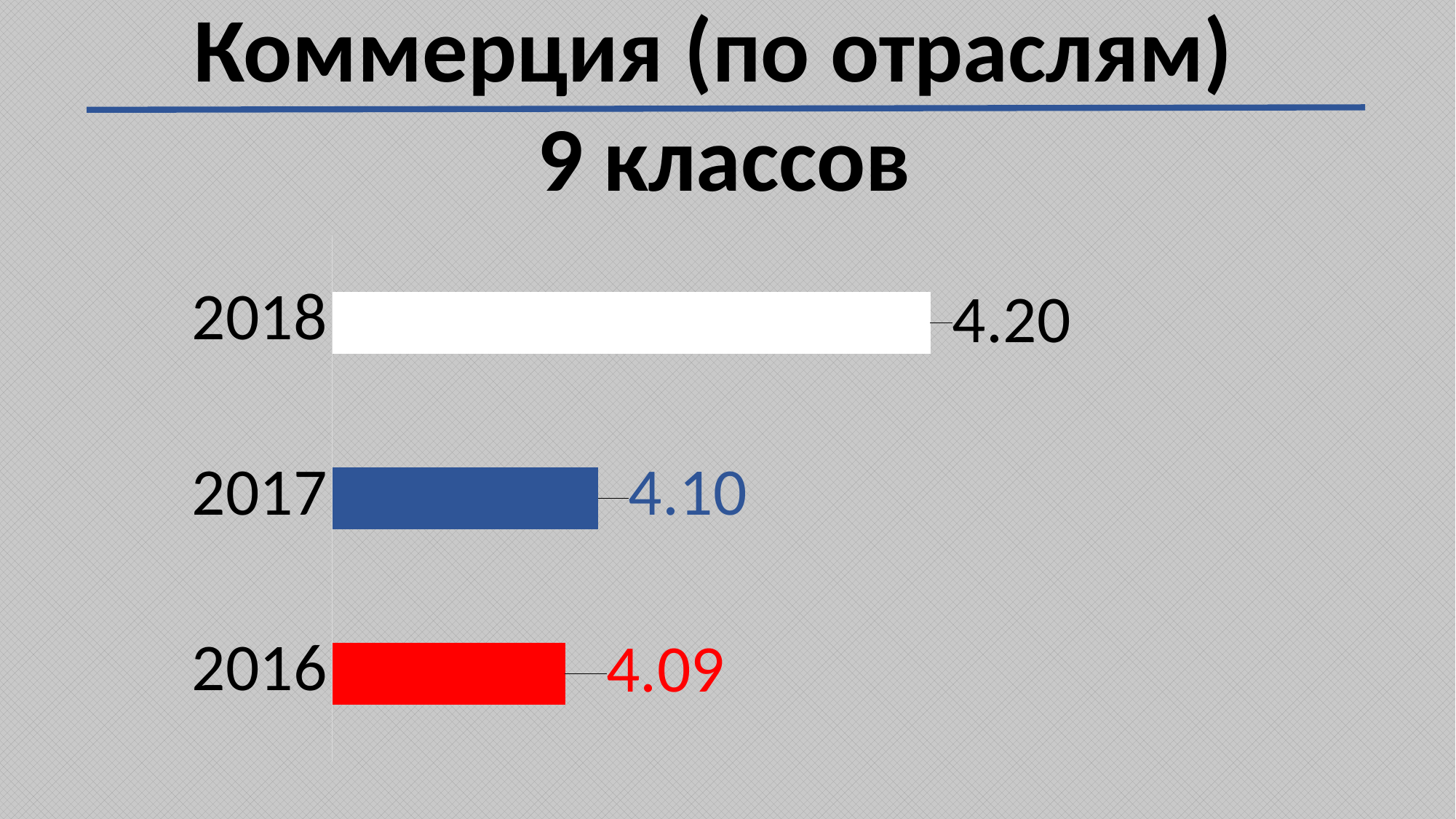
What is the value for 2016? 4.09 Which year has the lowest value? 2016 What is the difference between the values for 2018 and 2016? 0.11 Which is larger, the value for 2018 or the value for 2017? 2018 What colour is the bar for 2016? red What is the difference between the values for 2018 and 2017? 0.10 Do the values rise or fall from 2016 to 2018? rise Which year has the highest value? 2018 What kind of chart is shown on the slide? bar chart What is the value for 2017? 4.10 What is the value for 2018? 4.20 How many years are shown in the chart? 3